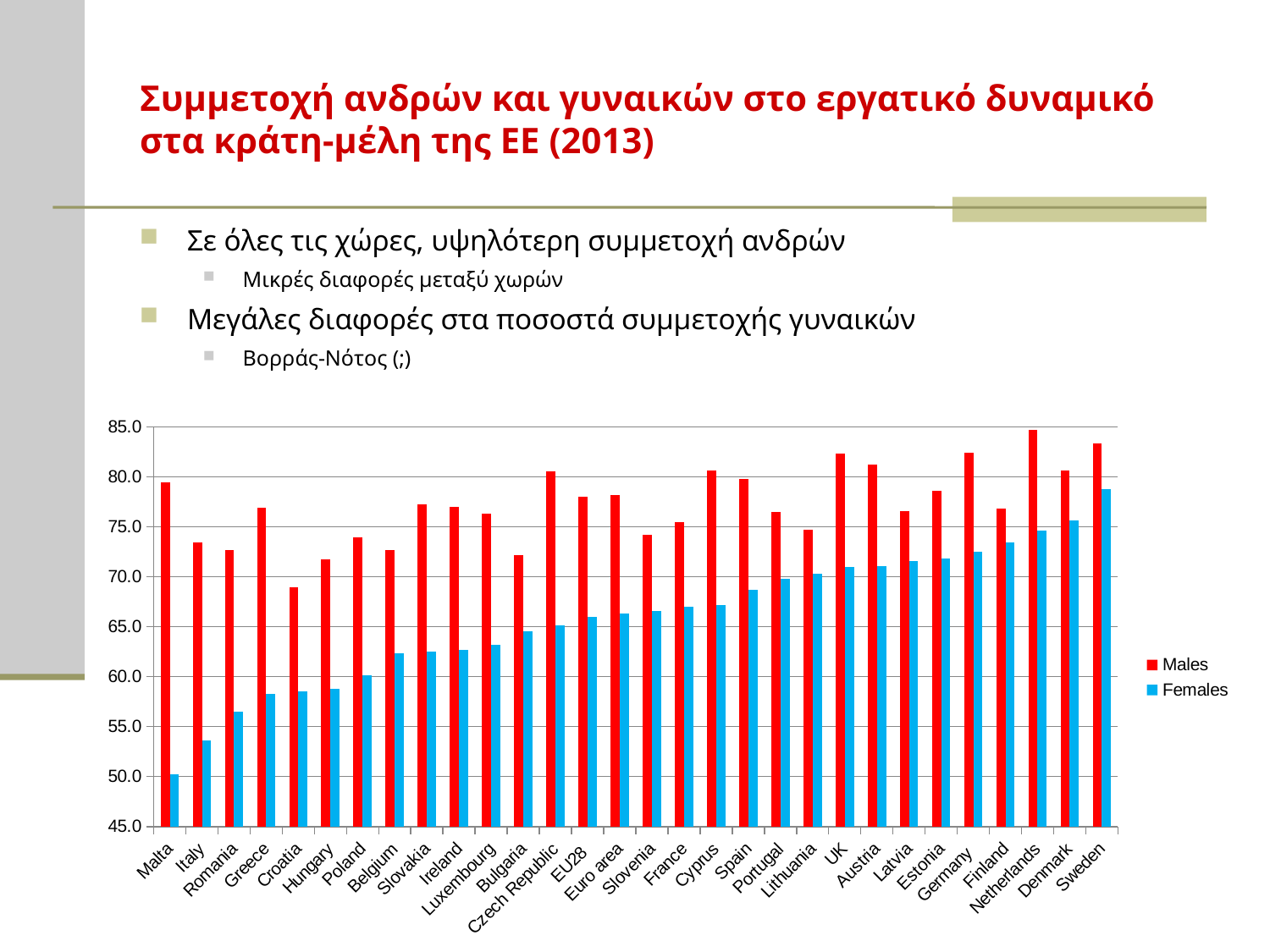
Which category has the lowest Females value? Malta Do the Females values generally rise or fall from left to right along the x axis? rise What kind of chart is shown on the slide? bar chart Which category has the lowest Males value? Croatia Is the Males value for Germany greater or less than 80.0? greater Which category has the highest Males value? Netherlands Which is larger, the Males value for Malta or the Males value for Italy? Malta How many series does the legend list? 2 How many countries/categories are shown on the x axis? 30 Is the Females value for Malta greater or less than 55.0? less Is the Females value for Sweden greater or less than 75.0? greater Which category has the highest Females value? Sweden